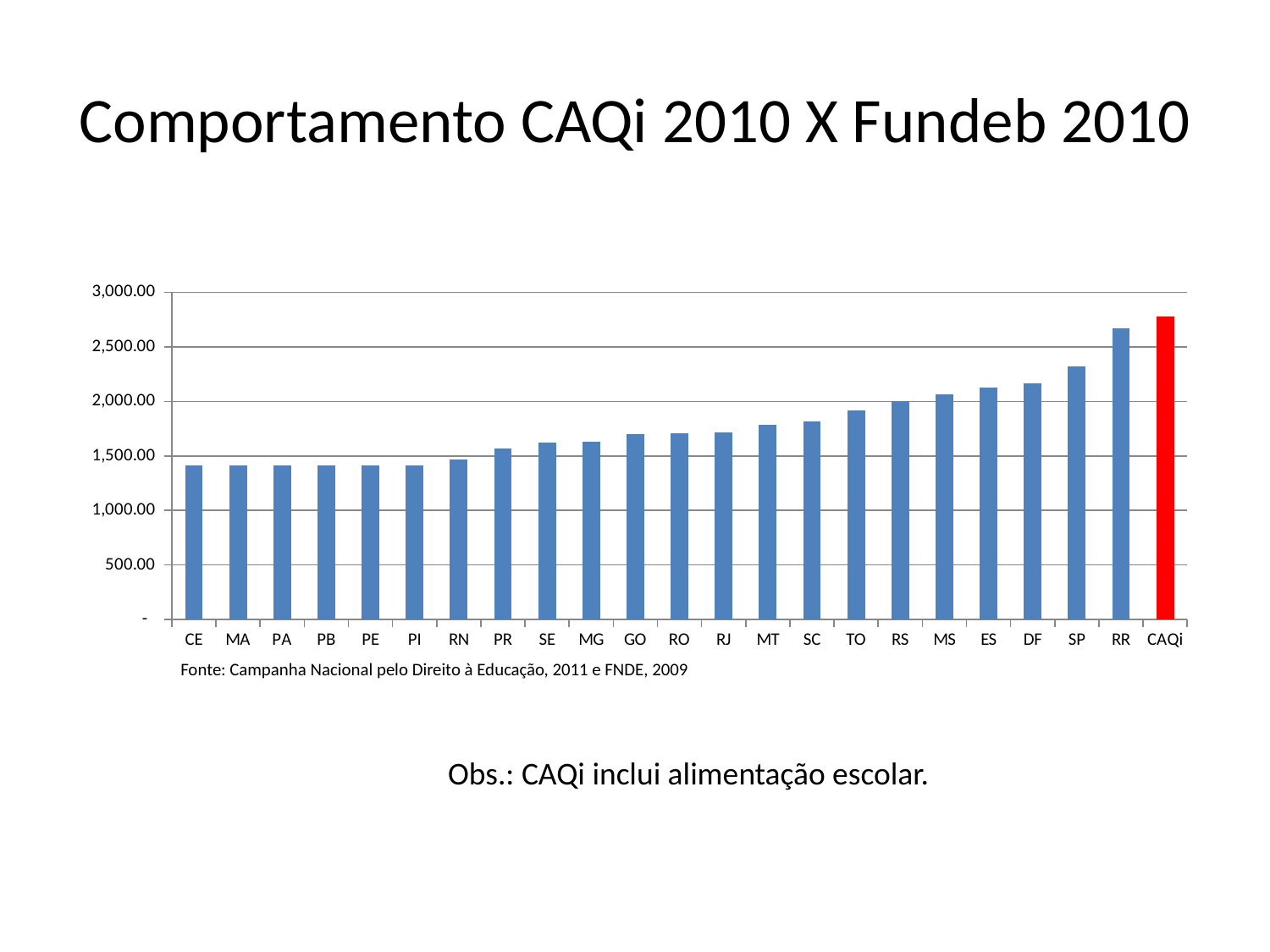
Do the bar values generally rise or fall from left to right along the x axis? rise Is the value for RR greater or less than 2,500.00? greater Which category has the highest bar? CAQi Is the value for CE greater or less than 1,500.00? less Which is larger, the value for GO or the value for RS? RS Which is larger, the value for SP or the value for DF? SP How many categories are plotted along the x axis? 23 Is the value for TO greater or less than 2,000.00? less What colour is the CAQi bar? red What kind of chart is shown on the slide? bar chart